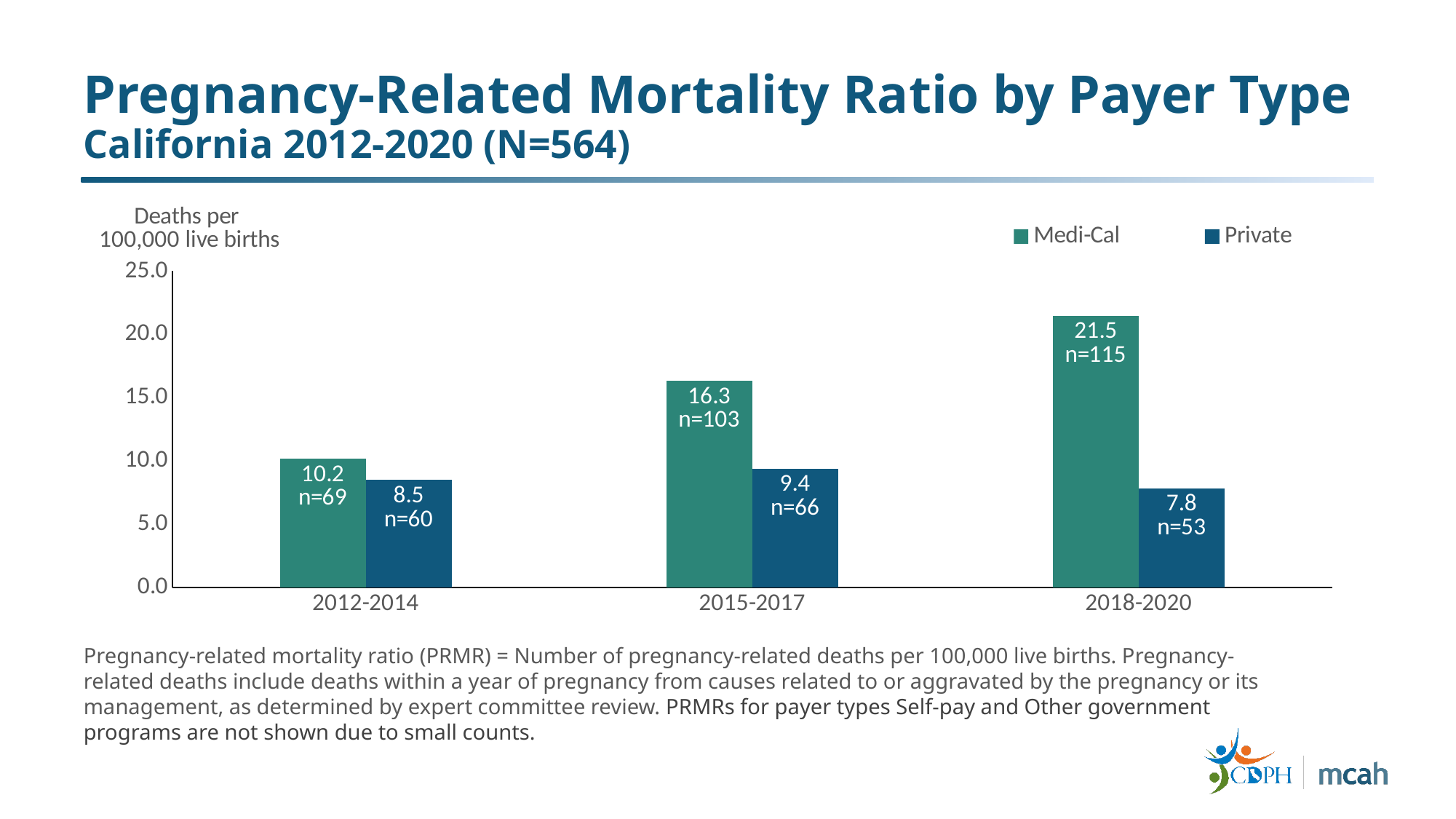
Which period has the highest Medi-Cal mortality ratio? 2018-2020 How many pregnancy-related deaths (n) are shown for Medi-Cal in 2015-2017? 103 Which is larger in 2015-2017, the Medi-Cal or the Private mortality ratio? Medi-Cal Is the Medi-Cal value for 2018-2020 greater or less than 20.0? greater Which period has the lowest Private mortality ratio? 2018-2020 What is the Medi-Cal pregnancy-related mortality ratio for 2018-2020? 21.5 What is the Private pregnancy-related mortality ratio for 2012-2014? 8.5 Does the Medi-Cal mortality ratio rise or fall across the periods from 2012-2014 to 2018-2020? Rise What is the difference between the Medi-Cal and Private mortality ratios in 2018-2020? 13.7 What kind of chart is shown on the slide? Bar chart How many time periods are shown on the x axis? 3 How many series does the legend list? 2